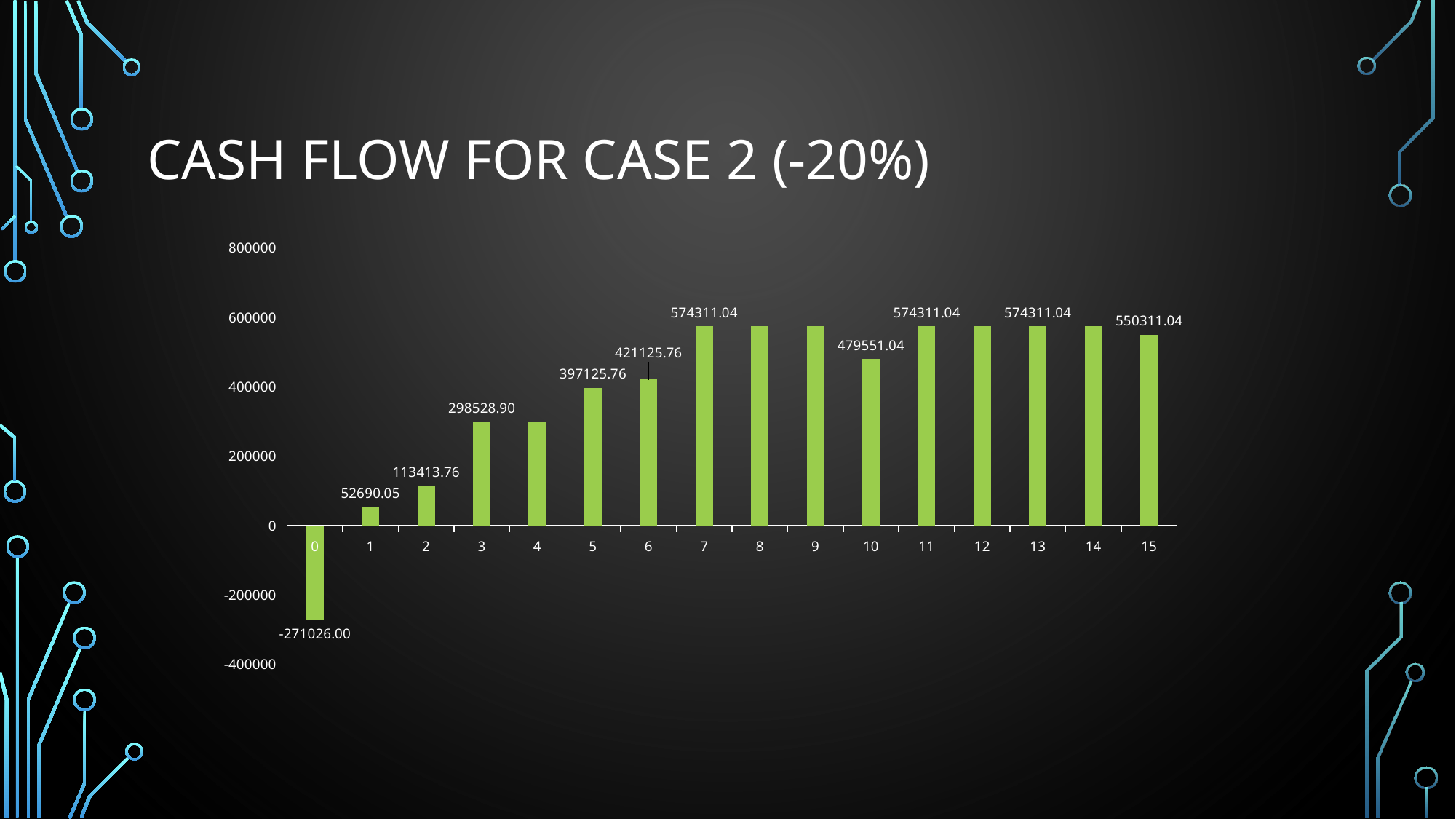
What type of chart is shown on the slide? bar chart What is the cash flow value for year 15? 550311.04 What is the cash flow value for year 0? -271026.00 What is the difference between the cash flow values for year 7 and year 10? 94760.00 Which is larger, the cash flow for year 13 or for year 15? year 13 What is the cash flow value for year 10? 479551.04 How many bars are plotted on the chart? 16 Which year has the lowest cash flow value? 0 What is the difference between the cash flow values for year 6 and year 5? 24000.00 What is the cash flow value for year 3? 298528.90 Is the value for year 4 greater or less than 400000? less What is the highest cash flow value labelled on the chart? 574311.04